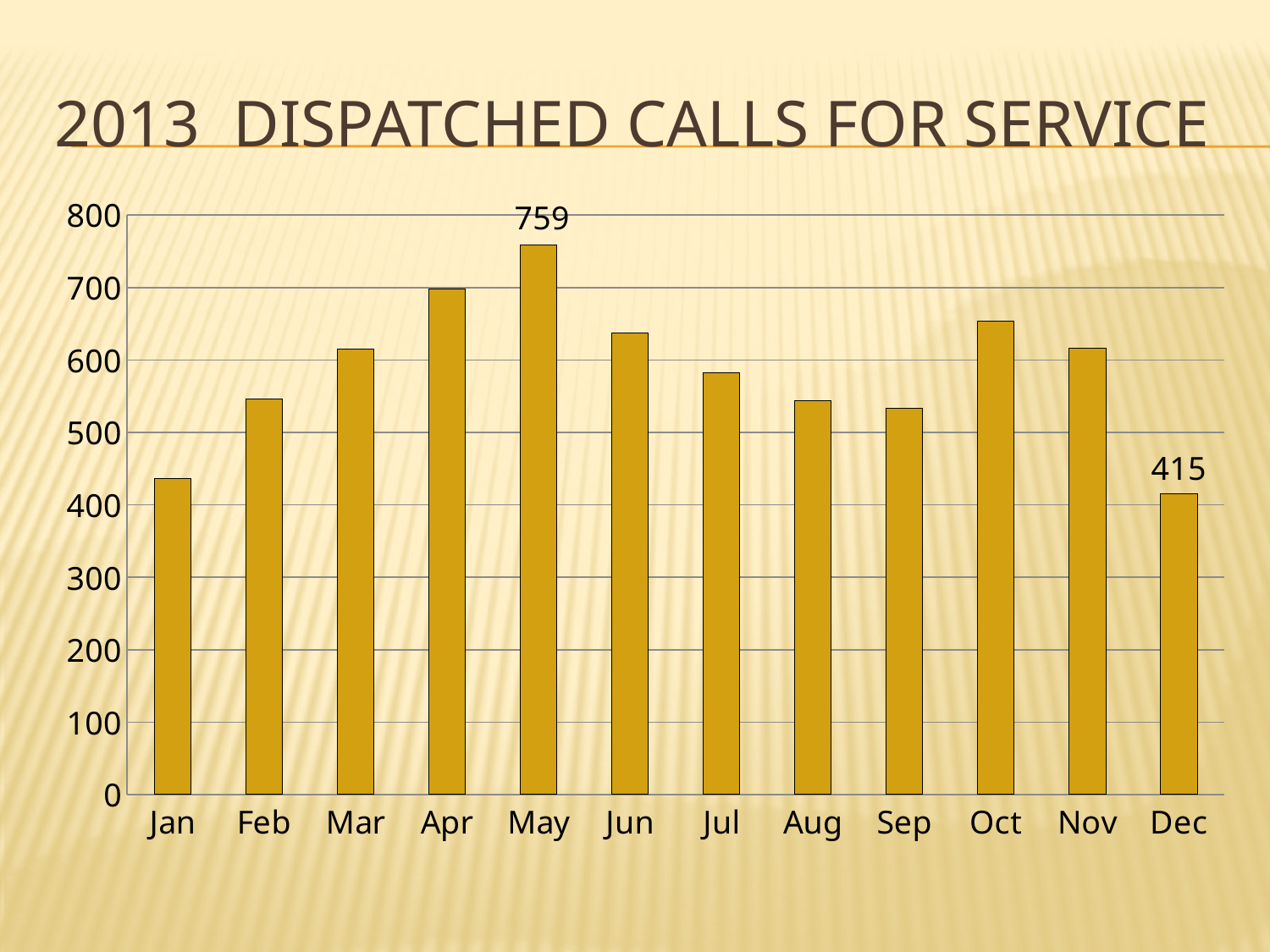
Which month has the lowest number of dispatched calls? Dec What is the difference between the values for May and Dec? 344 What is the value for Dec? 415 What kind of chart is shown on the slide? Bar chart Which is larger, the value for Apr or the value for Jun? Apr How many months are shown on the x axis? 12 Is the value for Oct greater or less than 600? greater What is the value for May? 759 What is the title of the slide? 2013 Dispatched Calls for Service Is the value for Jan greater or less than 500? less Which month has the highest number of dispatched calls? May Which is larger, the value for Jan or the value for Feb? Feb